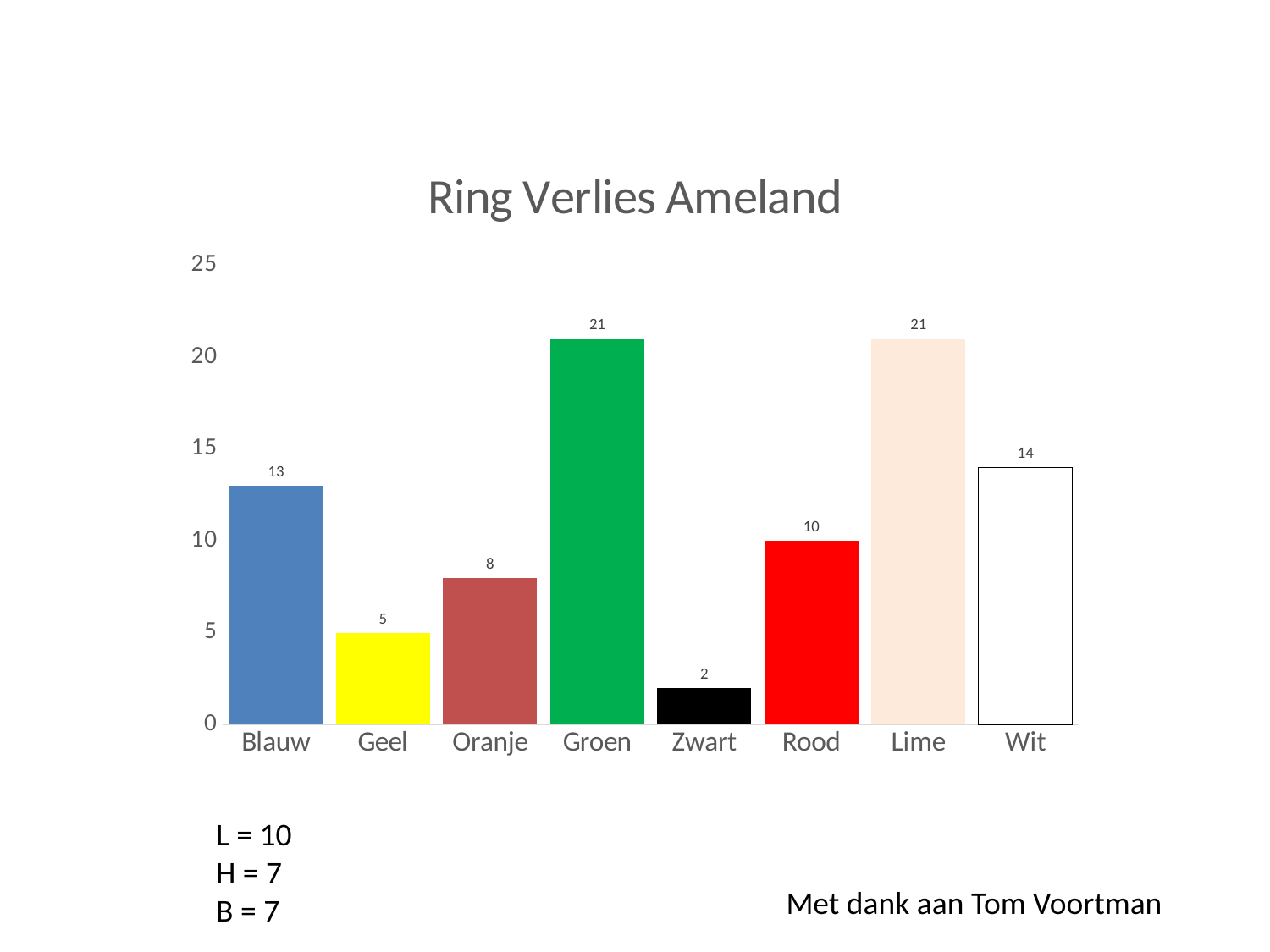
What is the difference between the values for Groen and Rood? 11 Which is larger, the value for Blauw or the value for Wit? Wit What is the title of the chart? Ring Verlies Ameland Which category has the lowest value? Zwart What is the value for Zwart? 2 How many categories are shown on the x axis? 8 Which is larger, the value for Oranje or the value for Rood? Rood What is the value for Wit? 14 What kind of chart is shown on the slide? bar chart Is the value for Lime greater or less than 20? greater What is the value for Blauw in the Ring Verlies Ameland chart? 13 What is the difference between the values for Wit and Geel? 9